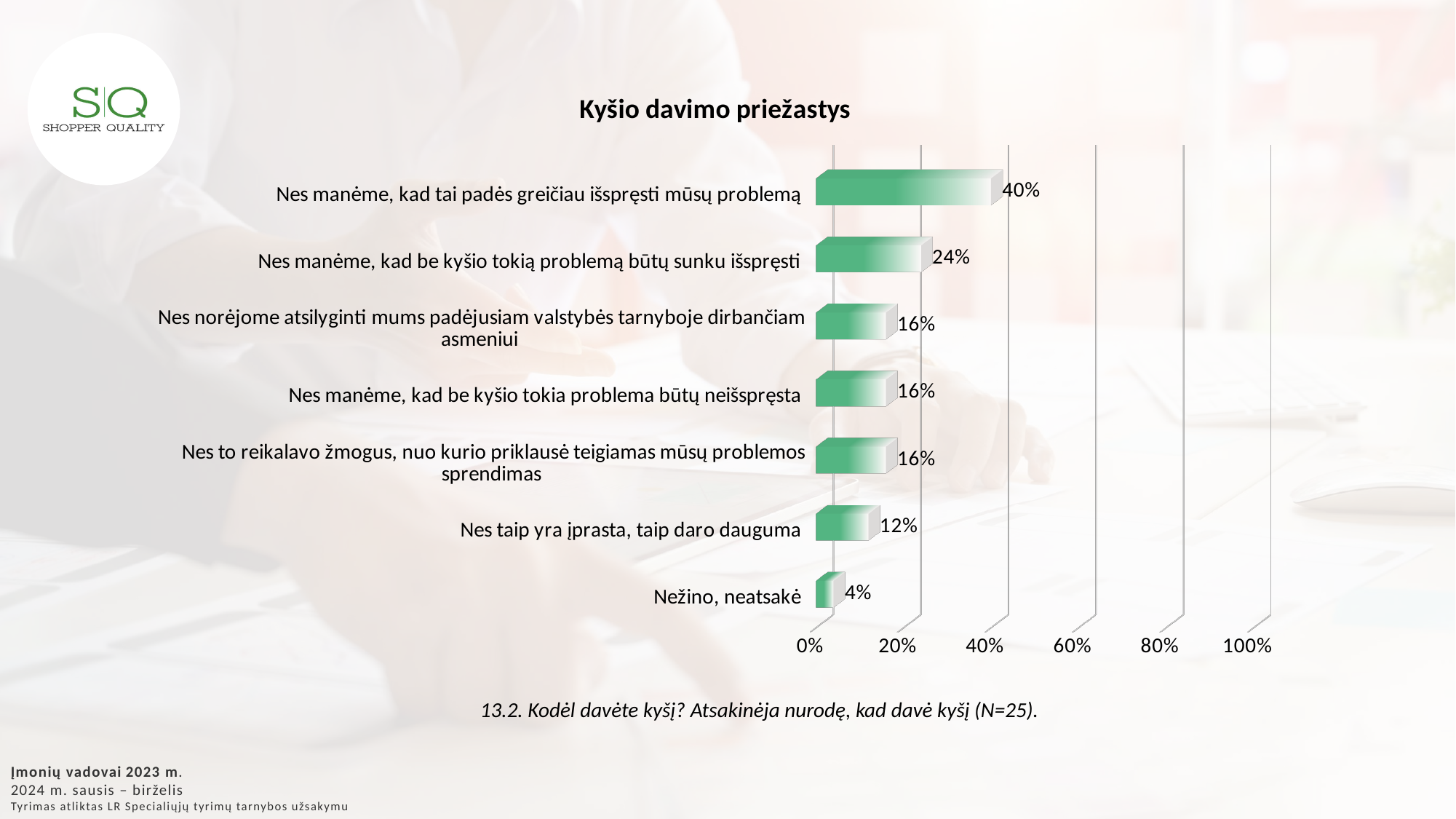
What is the value for "Nes manėme, kad be kyšio tokią problemą būtų sunku išspręsti"? 24% What is the value for "Nes manėme, kad tai padės greičiau išspręsti mūsų problemą"? 40% What is the value for "Nežino, neatsakė"? 4% What is the difference between the values for "Nes manėme, kad tai padės greičiau išspręsti mūsų problemą" and "Nes manėme, kad be kyšio tokią problemą būtų sunku išspręsti"? 16% What is the title of the chart? Kyšio davimo priežastys How many categories are shown in the chart? 7 What kind of chart is shown on the slide? bar chart What is the value for "Nes taip yra įprasta, taip daro dauguma"? 12% Which category has the highest value? Nes manėme, kad tai padės greičiau išspręsti mūsų problemą Which category has the lowest value? Nežino, neatsakė Which is larger: the value for "Nes taip yra įprasta, taip daro dauguma" or the value for "Nes manėme, kad be kyšio tokia problema būtų neišspręsta"? Nes manėme, kad be kyšio tokia problema būtų neišspręsta Is the value for "Nes manėme, kad be kyšio tokią problemą būtų sunku išspręsti" greater or less than 20%? greater